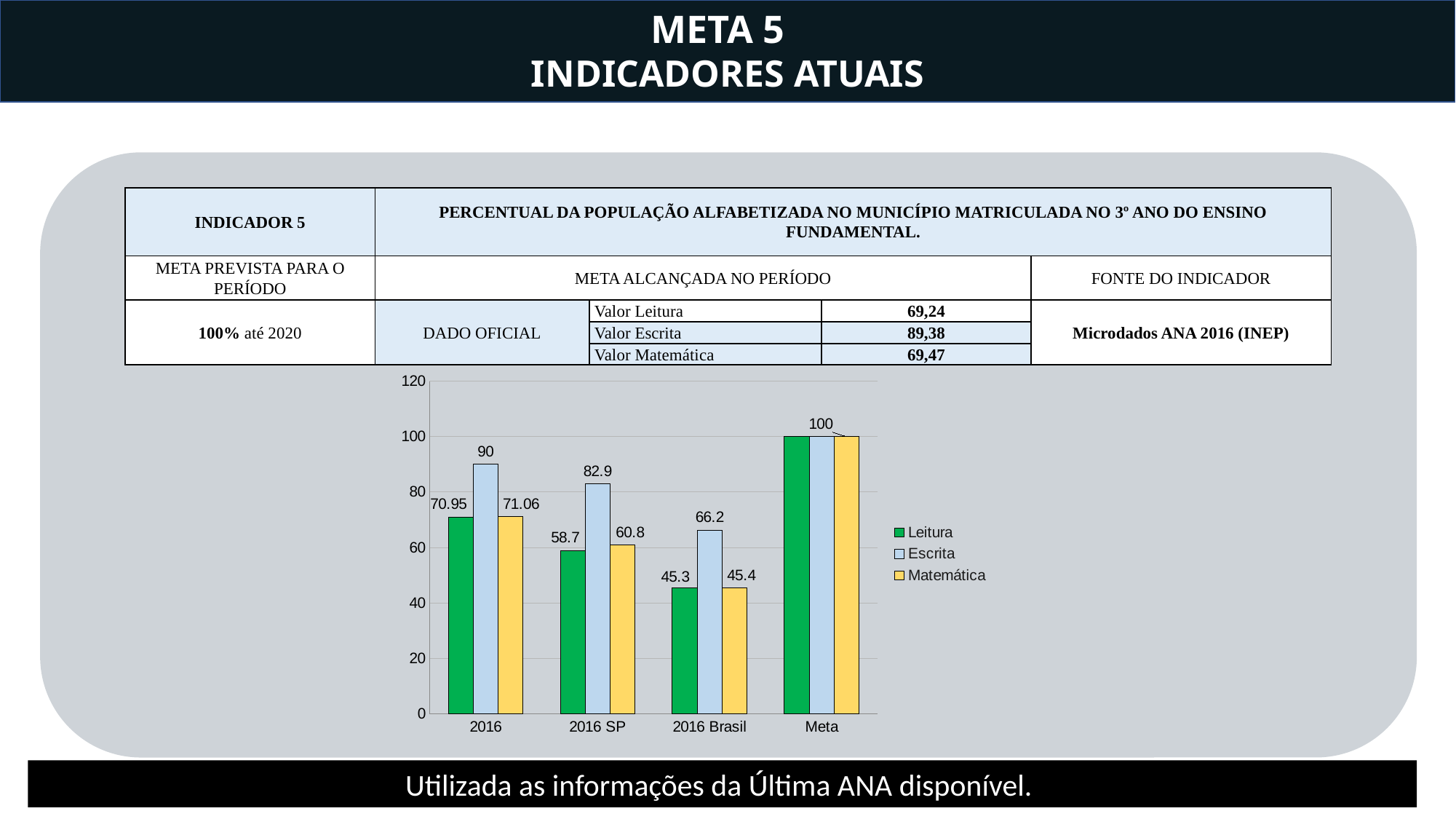
What is the difference between the Escrita value for 2016 and the Escrita value for 2016 SP? 7.1 Is the Escrita value for 2016 Brasil greater or less than 60? greater Which category has the lowest Leitura value in the chart? 2016 Brasil What kind of chart is shown on the slide? bar chart What is the Escrita value for 2016 in the chart? 90 What is the Escrita value for Meta in the chart? 100 What is the Matemática value for 2016 Brasil in the chart? 45.4 How many categories are shown on the x axis of the chart? 4 Which is larger in the chart: the Leitura value for 2016 or the Matemática value for 2016 SP? Leitura value for 2016 How many series does the chart legend list? 3 What is the Leitura value for 2016 SP in the chart? 58.7 Which category has the highest Escrita value in the chart? Meta